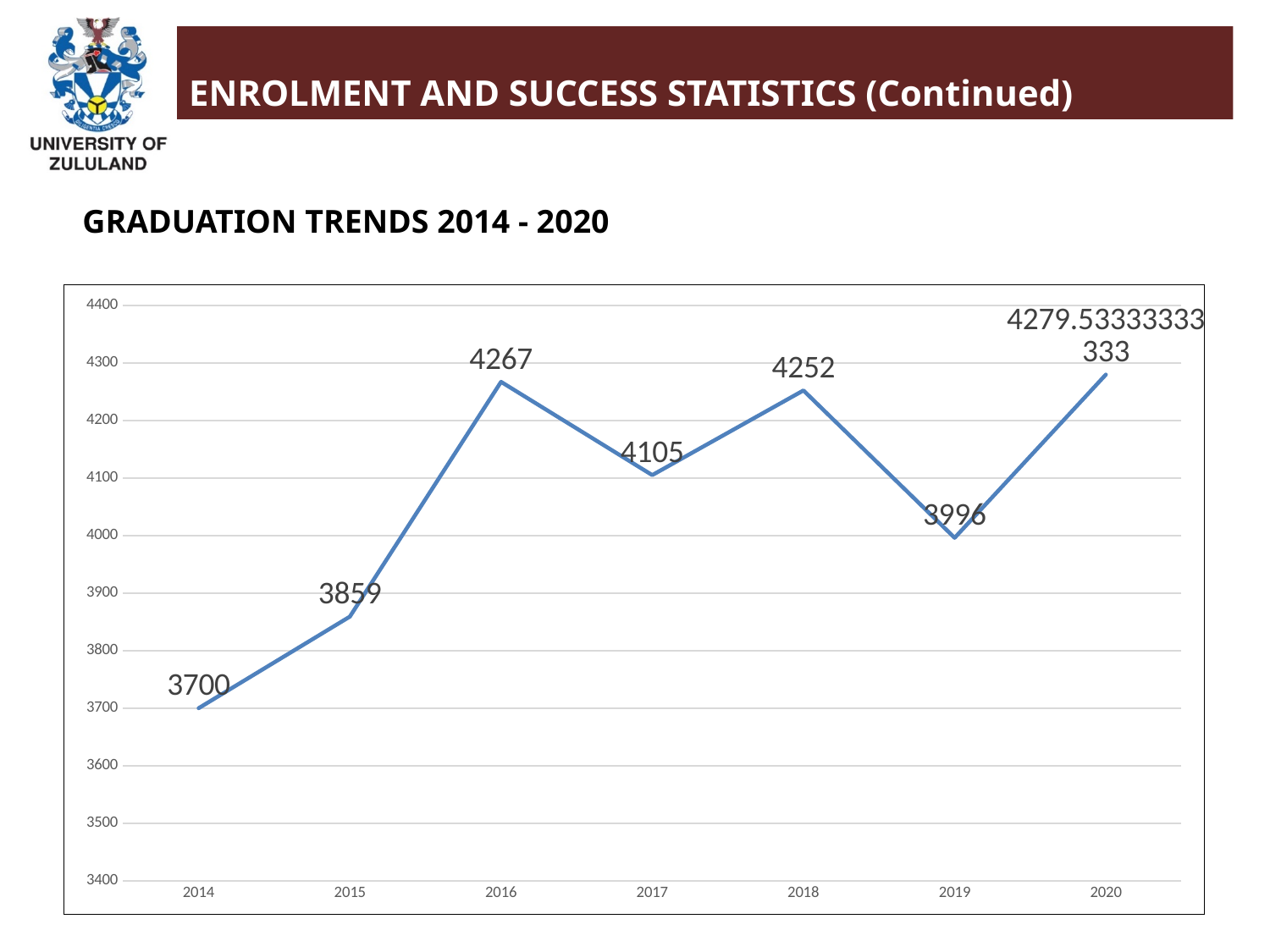
What type of chart is shown on the slide? line chart Which year has the lowest value? 2014 Which year has the highest value? 2020 How many years are plotted on the x axis? 7 What is the difference between the values for 2015 and 2014? 159 Does the value rise or fall from 2018 to 2019? fall What is the difference between the values for 2016 and 2017? 162 What is the value for 2018? 4252 What is the value for 2014? 3700 What is the value for 2019? 3996 Which is larger, the value for 2017 or the value for 2018? 2018 What is the value for 2016? 4267